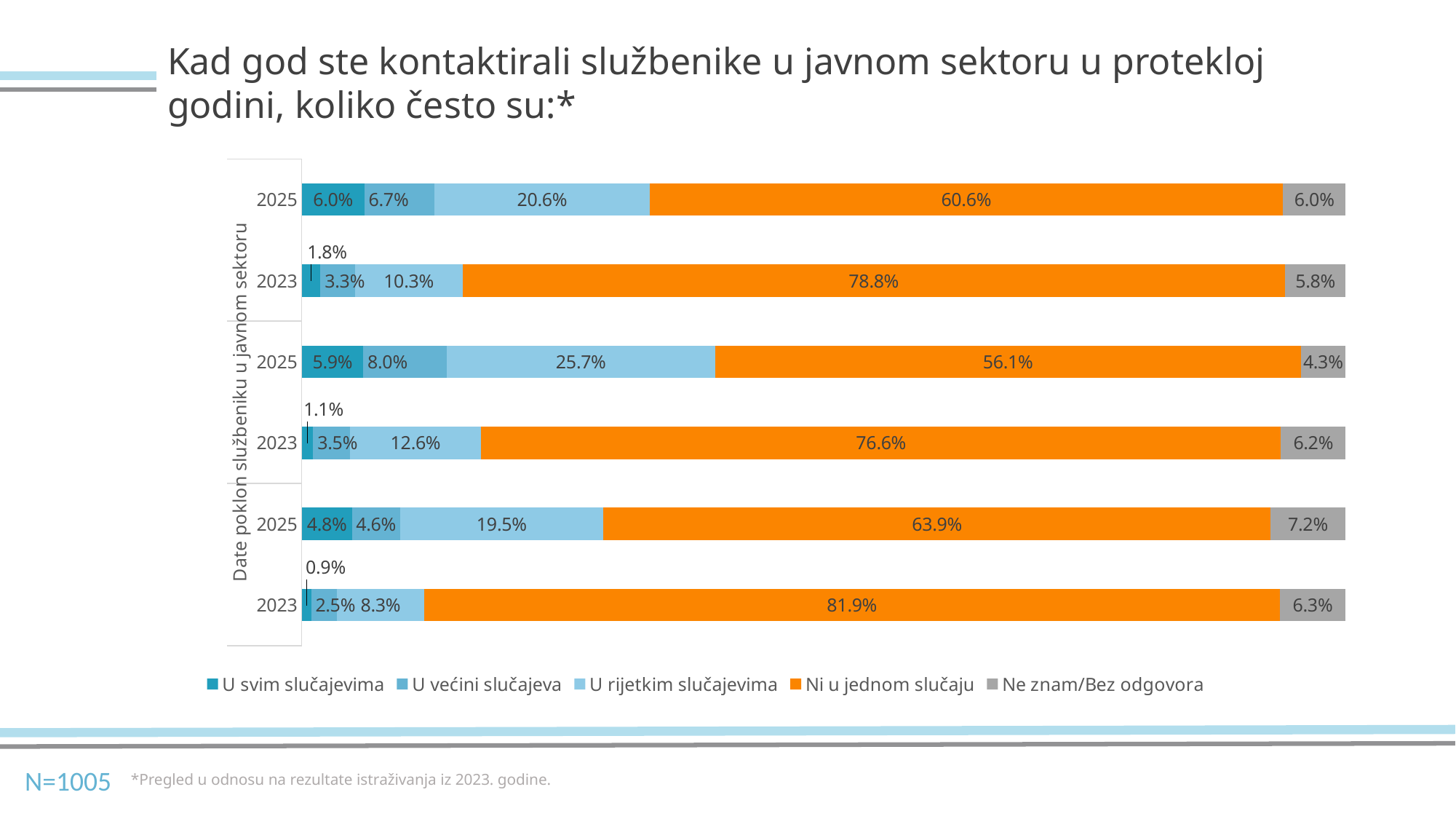
How many bars are plotted in the chart? 6 Which is larger: the 'U rijetkim slučajevima' value in the middle 2025 bar or in the topmost 2025 bar? The middle 2025 bar (25.7%) In the bottom 2023 bar, what is the value for 'Ni u jednom slučaju'? 81.9% In the top pair of bars, what is the difference between the 'Ni u jednom slučaju' values for 2023 and 2025? 18.2 percentage points What kind of chart is shown on the slide? Stacked bar chart How many series does the legend list? 5 In the bottom 2025 bar, what is the value for 'Ne znam/Bez odgovora'? 7.2% In the topmost 2025 bar, what is the value for 'Ni u jednom slučaju'? 60.6% Which bar has the highest 'Ni u jednom slučaju' value? The bottom 2023 bar (81.9%) What is the last entry in the legend? Ne znam/Bez odgovora Which bar has the lowest 'U svim slučajevima' value? The bottom 2023 bar (0.9%) In the middle 2023 bar, what is the value for 'U svim slučajevima'? 1.1%